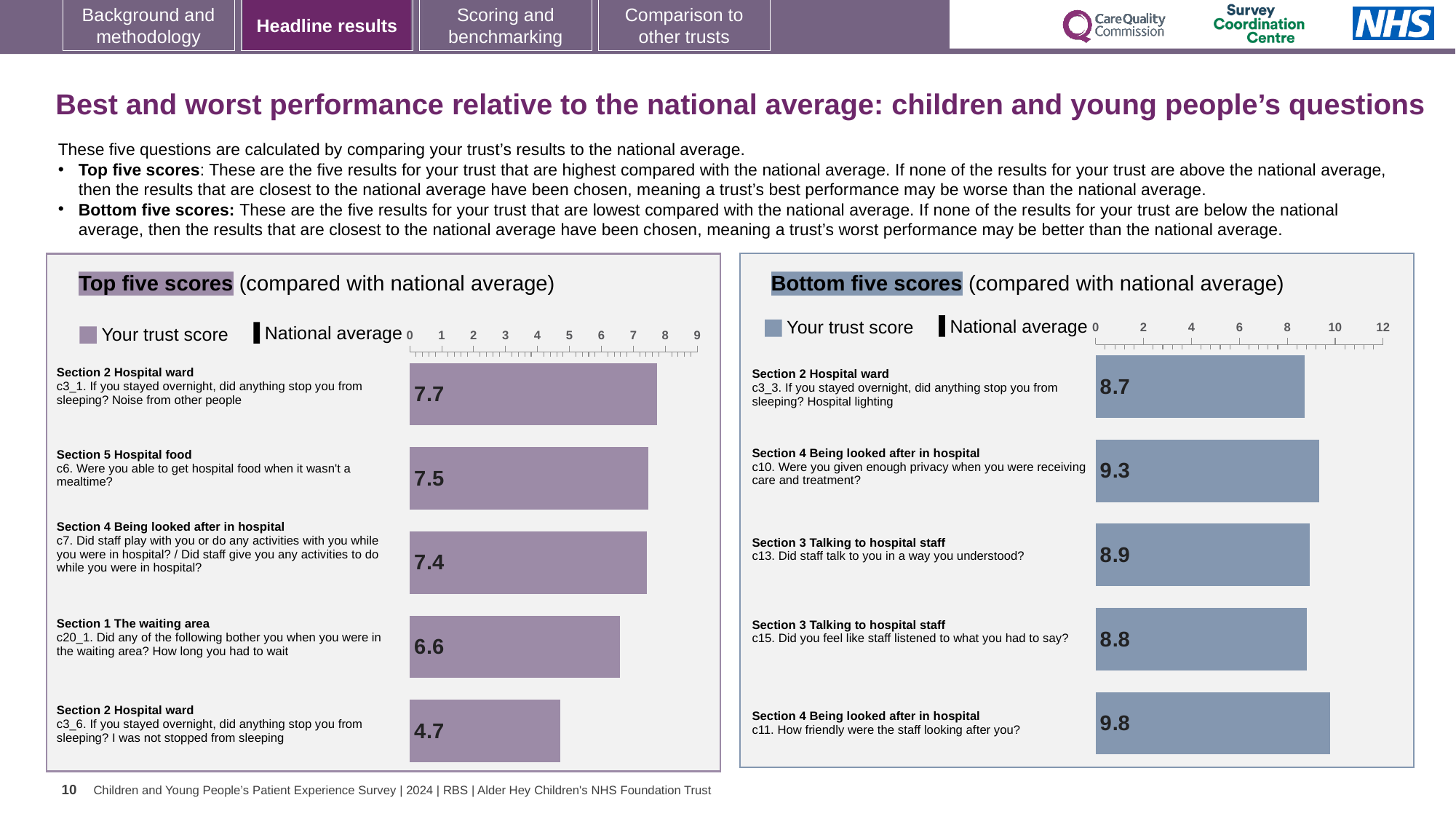
In the Top five scores chart, what is the trust score for c3_6 (I was not stopped from sleeping)? 4.7 What type of chart is the Bottom five scores chart? Bar chart In the Bottom five scores chart, which has the larger trust score: c10 or c15? c10 In the Top five scores chart, what is the trust score for c6 (Were you able to get hospital food when it wasn't a mealtime?)? 7.5 In the Top five scores chart, what is the difference between the trust scores for c3_1 and c3_6? 3.0 In the Bottom five scores chart, what is the trust score for c11 (How friendly were the staff looking after you?)? 9.8 How many series does the legend of the Top five scores chart list? 2 In the Bottom five scores chart, what is the difference between the trust scores for c11 and c10? 0.5 In the Bottom five scores chart, which question has the lowest trust score? c3_3 (Hospital lighting) How many questions are shown in the Top five scores chart? 5 In the Bottom five scores chart, what is the trust score for c13 (Did staff talk to you in a way you understood?)? 8.9 In the Top five scores chart, which question has the highest trust score? c3_1 (Noise from other people)